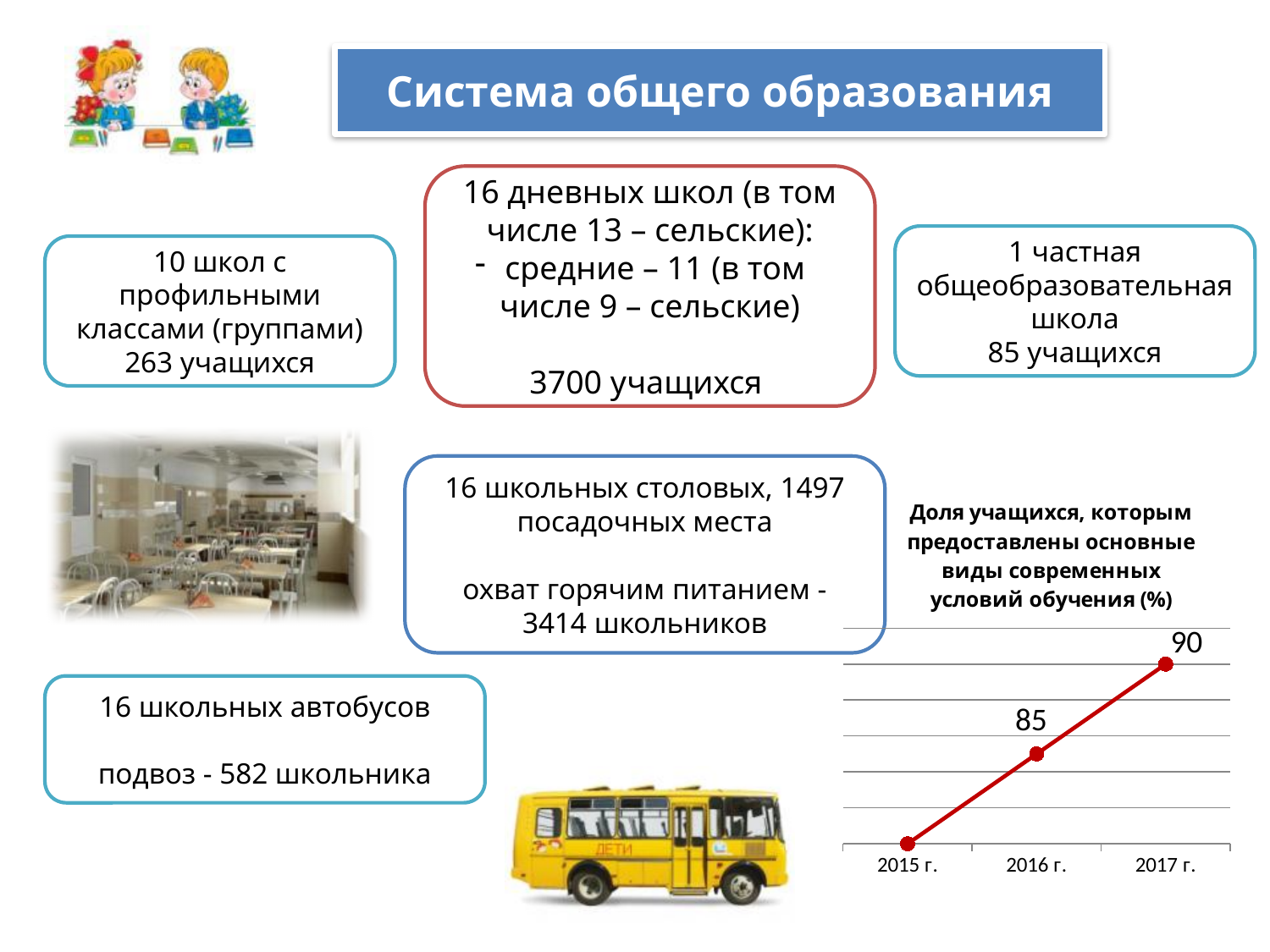
What colour is the line in the chart? red What is the title of the chart? Доля учащихся, которым предоставлены основные виды современных условий обучения (%) Do the values rise or fall from 2015 г. to 2017 г.? rise What is the difference between the values for 2017 г. and 2016 г.? 5 Which is larger, the value for 2015 г. or the value for 2016 г.? 2016 г. What kind of chart is shown on the slide? line chart Which year has the highest value in the chart? 2017 г. What is the value for 2016 г. in the chart? 85 Which is larger, the value for 2016 г. or the value for 2017 г.? 2017 г. Which year has the lowest value in the chart? 2015 г. How many data points are plotted in the chart? 3 What is the value for 2017 г. in the chart? 90